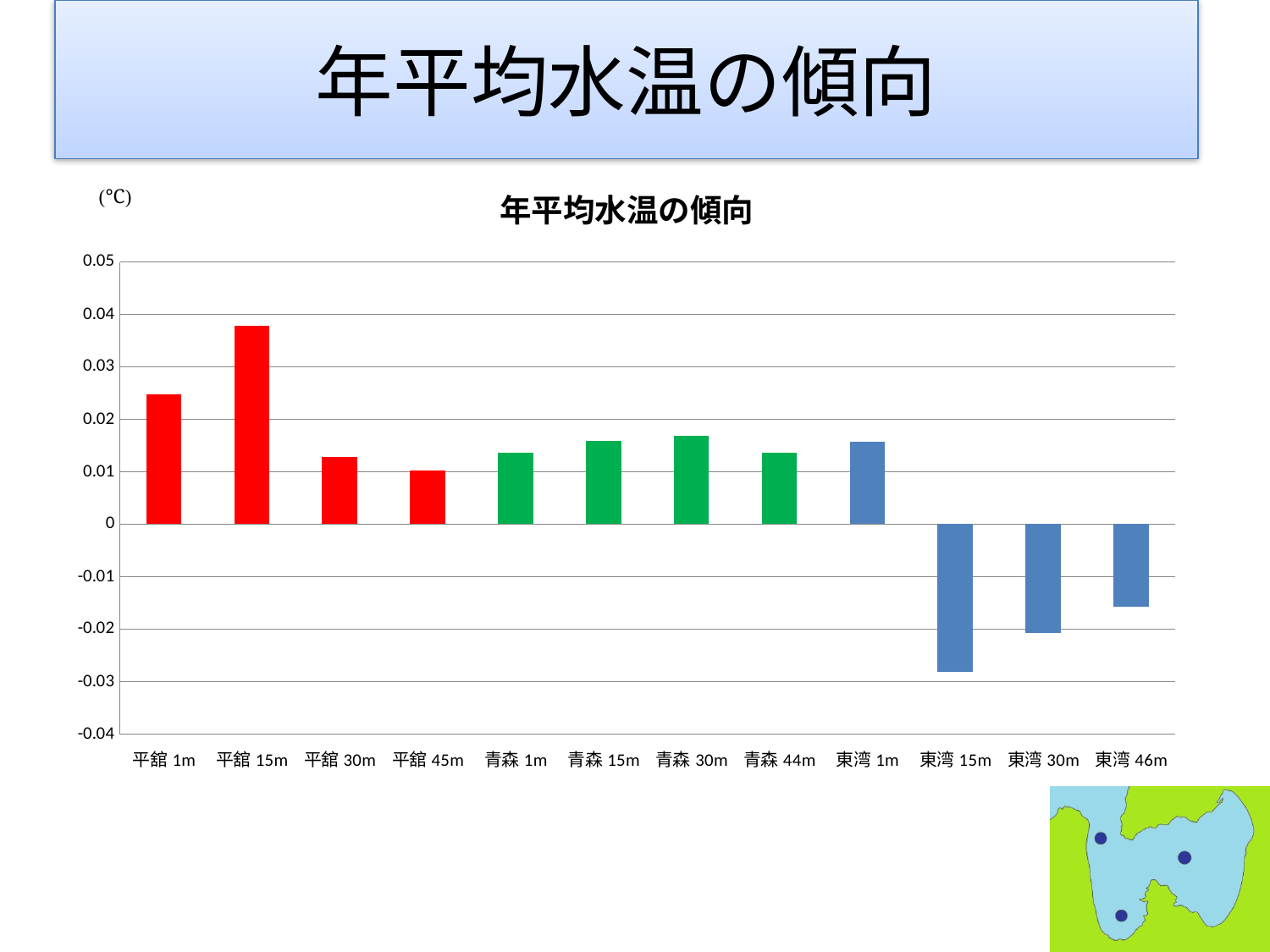
Is the value for 東湾 46m greater or less than -0.02? greater Is the value for 東湾 15m greater or less than -0.02? less Is the value for 平舘 15m greater or less than 0.03? greater How many categories are plotted on the x axis? 12 What kind of chart is shown on the slide? bar chart Which category has the lowest value? 東湾 15m Which is larger, the value for 平舘 1m or the value for 平舘 45m? 平舘 1m Which category has the highest value? 平舘 15m What colour are the bars for the 青森 categories? green What is the title of the chart? 年平均水温の傾向 How many categories have negative values? 3